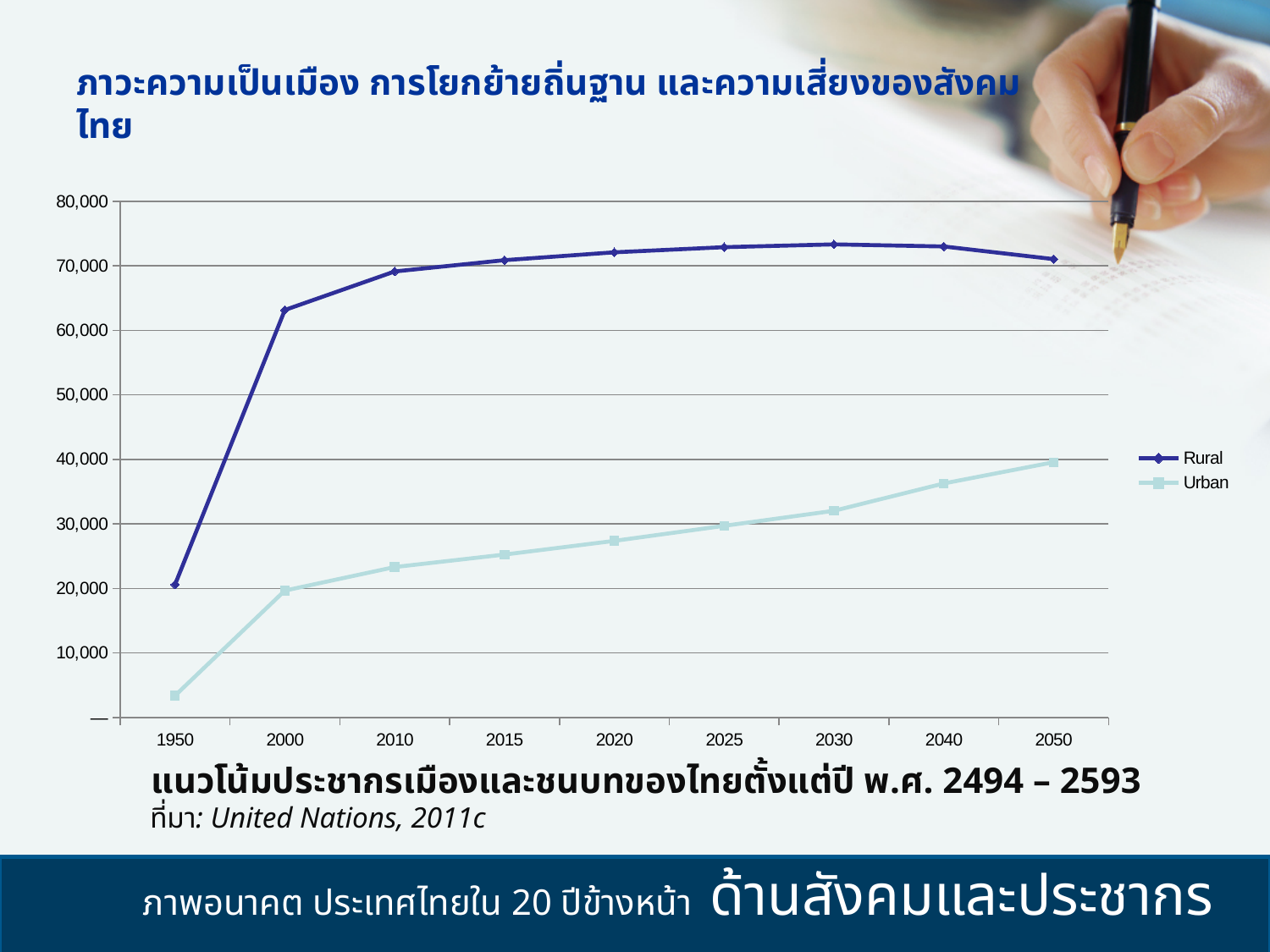
Is the Urban value for 2040 greater or less than 30,000? greater Is the Urban value for 1950 greater or less than 10,000? less In which year is the Urban series at its highest? 2050 What are the two series named in the legend? Rural and Urban Does the Urban series rise or fall from 1950 to 2050? rise Is the Rural value for 2000 greater or less than 60,000? greater What kind of chart is shown on the slide? line chart How many series does the legend list? 2 In which year is the Rural series at its lowest? 1950 How many years are plotted along the x axis? 9 In 2050, which series has the larger value, Rural or Urban? Rural What source is cited below the chart? United Nations, 2011c